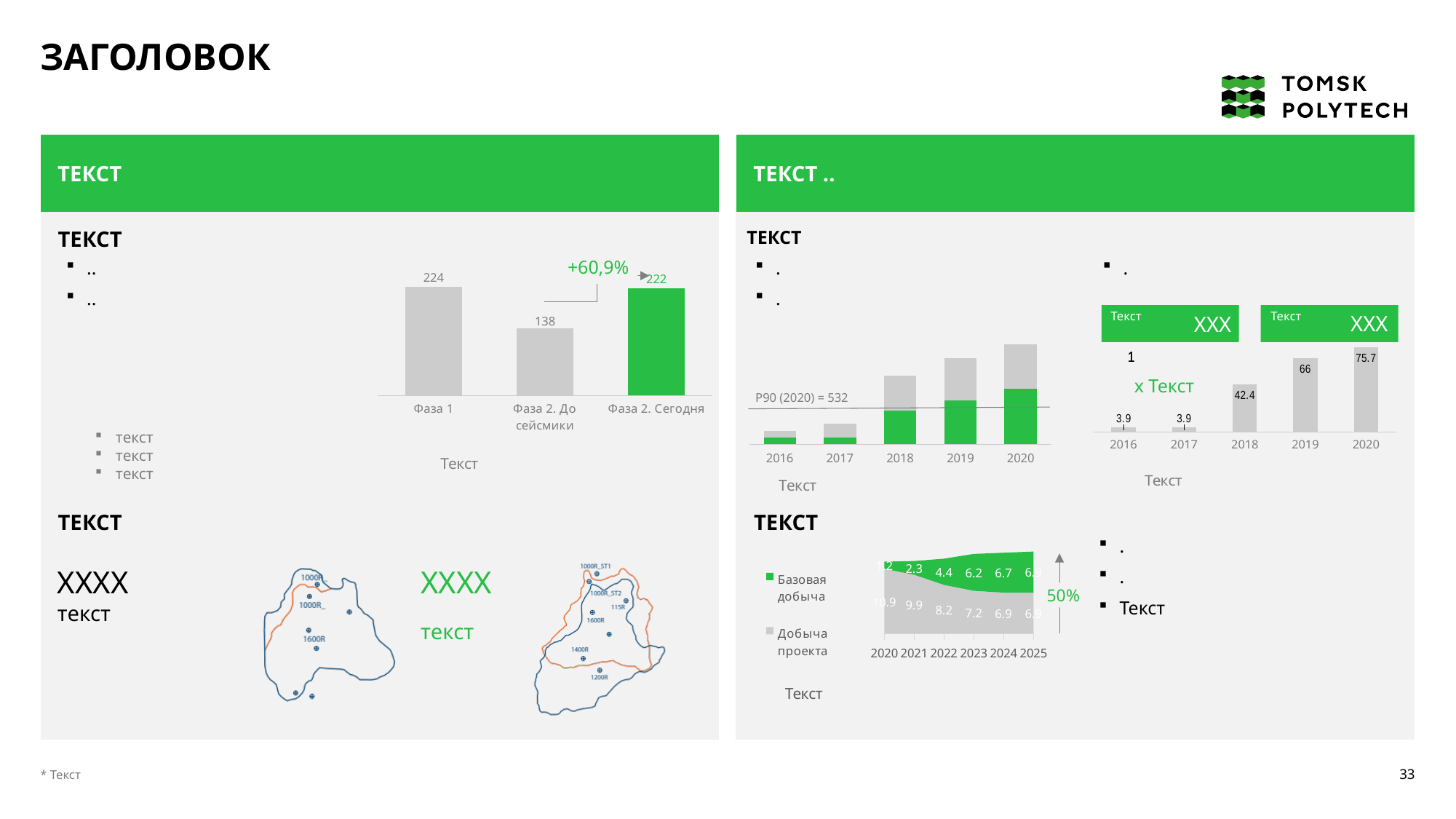
In the top-left bar chart with phase categories, which category has the lowest value? Фаза 2. До сейсмики In the top-left bar chart with phase categories, what is the value for Фаза 1? 224 In the bar chart on the right side of the right panel with years 2016–2020, what is the difference between the values for 2019 and 2018? 23.6 In the top-left bar chart with phase categories, what percentage change is annotated above the bars? +60,9% In the top-left bar chart with phase categories, what is the value for Фаза 2. Сегодня? 222 In the bar chart on the right side of the right panel with years 2016–2020, do the values rise or fall from 2016 to 2020? rise In the bottom area chart with years 2020–2025, how many series does the legend list? 2 In the bar chart on the right side of the right panel with years 2016–2020, what is the value for 2018? 42.4 In the top-left bar chart with phase categories, what is the difference between the values for Фаза 1 and Фаза 2. До сейсмики? 86 In the bar chart on the right side of the right panel with years 2016–2020, what is the value for 2020? 75.7 In the bottom area chart with years 2020–2025, what is the value for Добыча проекта in 2020? 10.9 In the top-left bar chart with phase categories, what is the value for Фаза 2. До сейсмики? 138